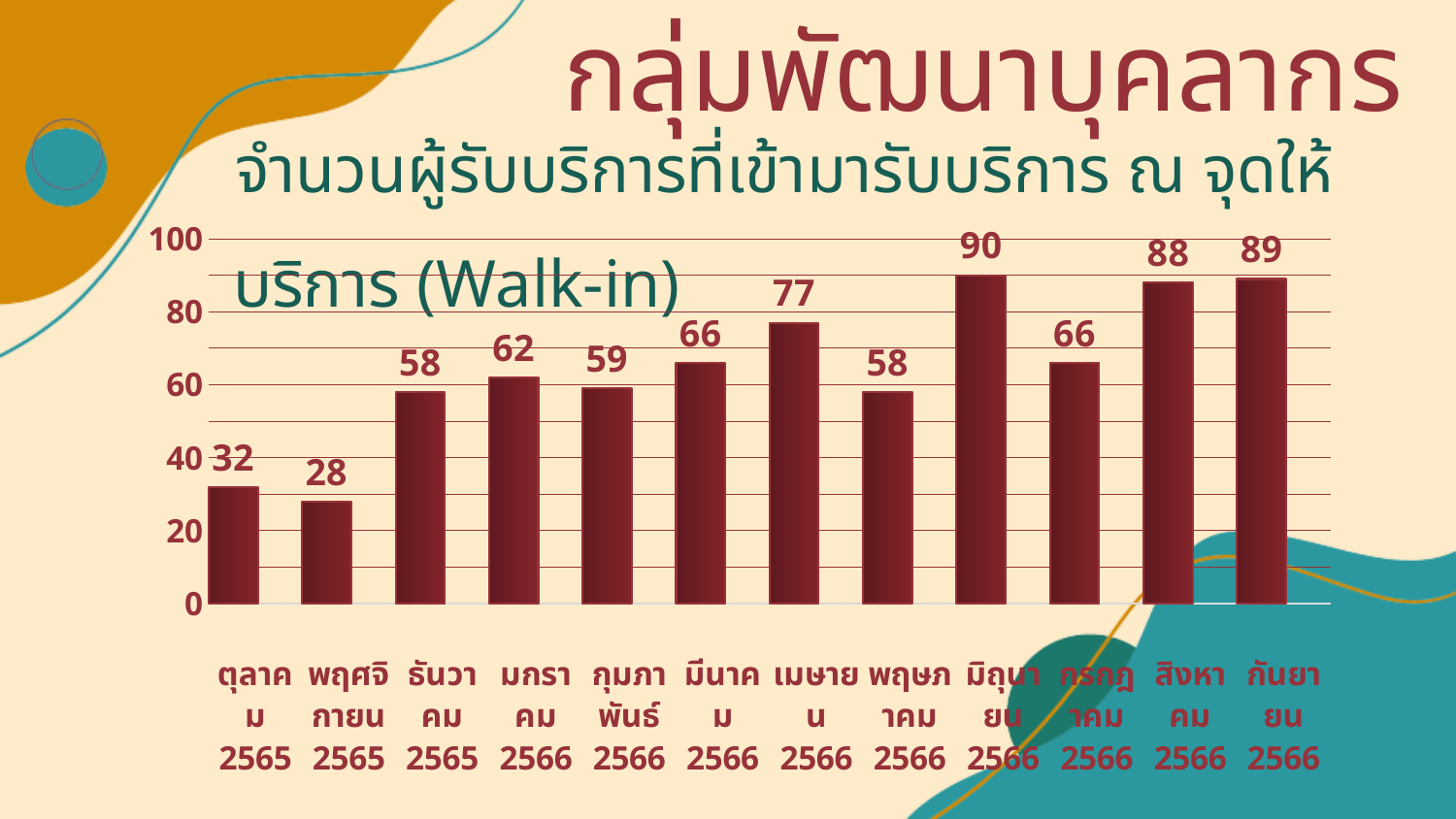
Is the value for ธันวาคม 2565 greater or less than 40? greater What kind of chart is shown on the slide? bar chart Which month has the lowest value? พฤศจิกายน 2565 (November 2022) Which is larger, the value for มกราคม 2566 or the value for กุมภาพันธ์ 2566? มกราคม 2566 Which month has the highest value? มิถุนายน 2566 (June 2023) What is the value for เมษายน 2566 (April 2023)? 77 What is the highest value shown on the y axis? 100 What is the value for ตุลาคม 2565 (October 2022)? 32 What is the difference between the values for กันยายน 2566 and สิงหาคม 2566? 1 What is the difference between the values for มิถุนายน 2566 and พฤศจิกายน 2565? 62 What is the value for กรกฎาคม 2566 (July 2023)? 66 How many months are shown on the x axis? 12